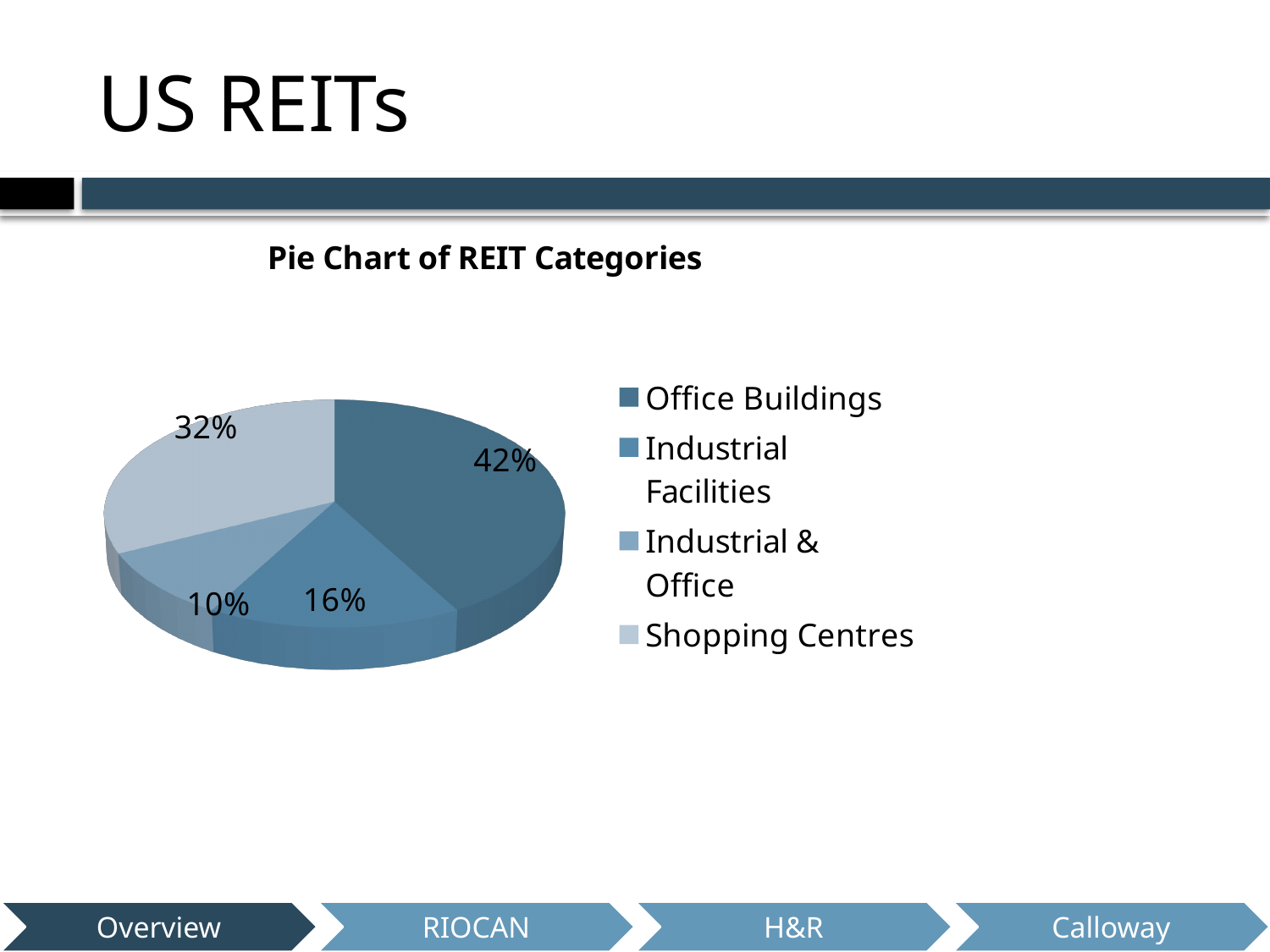
What type of chart is shown on the slide? Pie chart What percentage is shown for Shopping Centres? 32% How many categories are shown in the pie chart? 4 Which is larger, Shopping Centres or Industrial Facilities? Shopping Centres Which REIT category has the largest slice of the pie? Office Buildings What is the difference in percentage points between Office Buildings and Shopping Centres? 10 What percentage is shown for Industrial & Office? 10% What is the title of the chart? Pie Chart of REIT Categories What is the difference in percentage points between Industrial Facilities and Industrial & Office? 6 What share of the pie does Office Buildings represent? 42% What percentage is shown for Industrial Facilities? 16% Which REIT category has the smallest slice of the pie? Industrial & Office